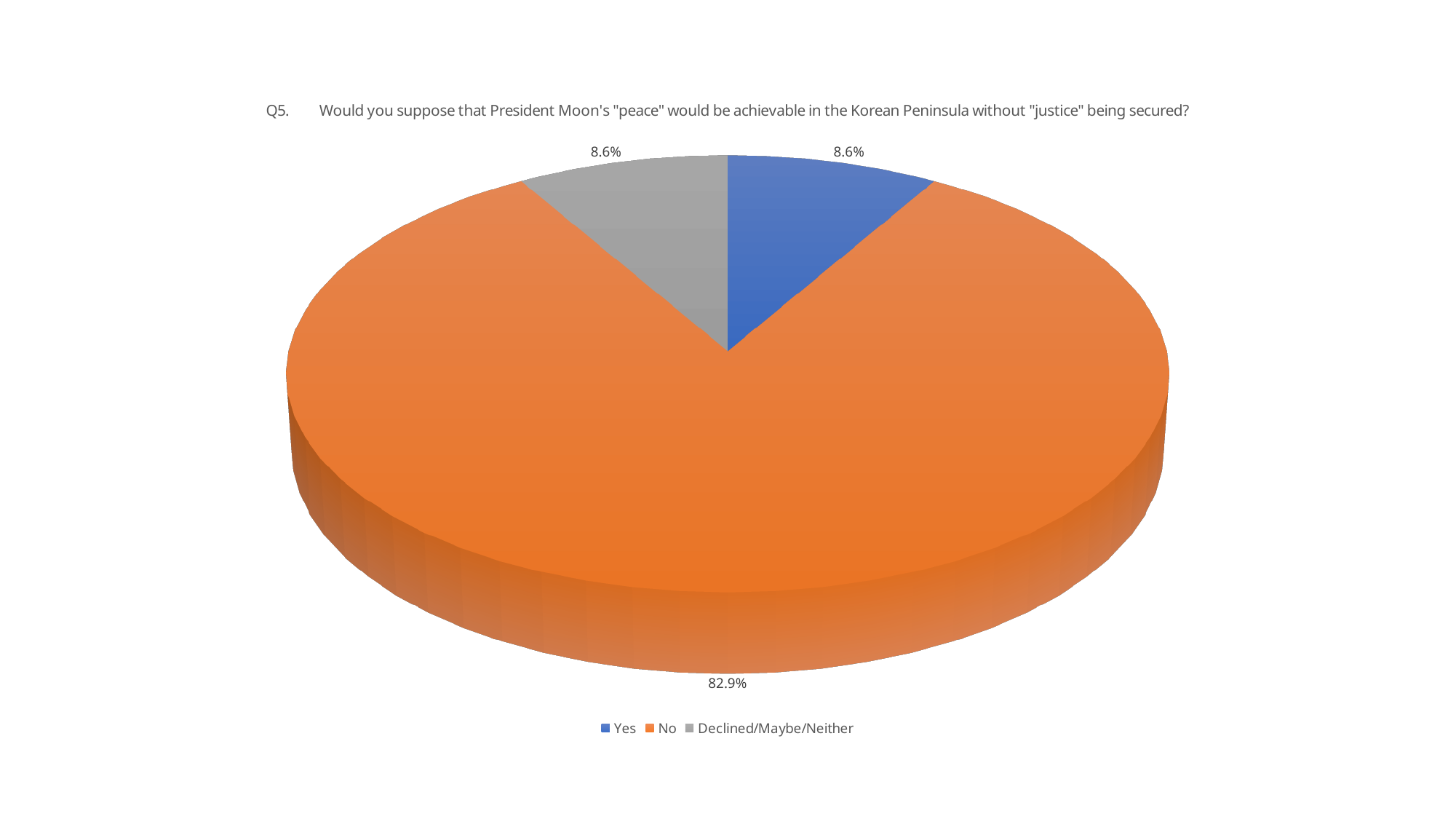
Which response category has the largest share of the pie? No Which colour represents the "No" slice? Orange How many slices does the pie chart have? 3 What is the difference in percentage points between the "No" share and the "Yes" share? 74.3 What share of respondents answered "No"? 82.9% What question number is shown in the chart title? Q5 What is the combined share of "Yes" and "Declined/Maybe/Neither"? 17.2% How many categories does the legend list? 3 What kind of chart is shown on the slide? Pie chart What share of respondents answered "Yes"? 8.6% Which is larger, the share for "No" or the share for "Declined/Maybe/Neither"? No What share of respondents fall under "Declined/Maybe/Neither"? 8.6%